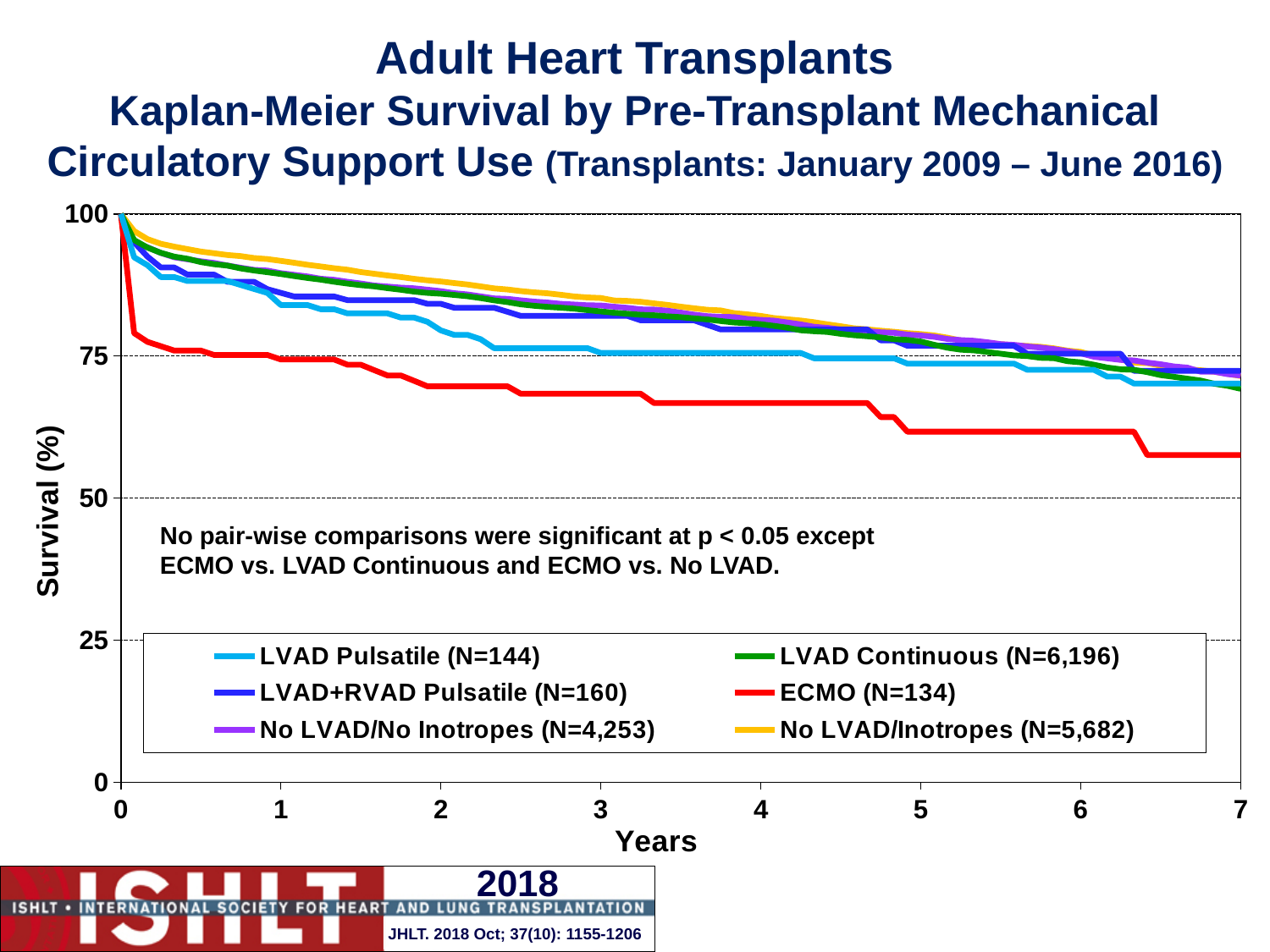
How many series does the legend list? 6 What kind of chart is shown on the slide? Line chart Is the survival for LVAD Pulsatile at 3 years greater or less than 50? greater Which group has the highest survival at 1 year? No LVAD/Inotropes (N=5,682) Is the survival for ECMO at 7 years greater or less than 75? less Which group has the lowest survival at 7 years? ECMO (N=134) What is the label of the y axis? Survival (%) At 4 years, which group has higher survival: ECMO or LVAD Continuous? LVAD Continuous Is the survival for ECMO at 7 years greater or less than 50? greater What is the sample size (N) shown in the legend for LVAD Continuous? 6,196 Do the survival curves rise or fall as years increase? Fall